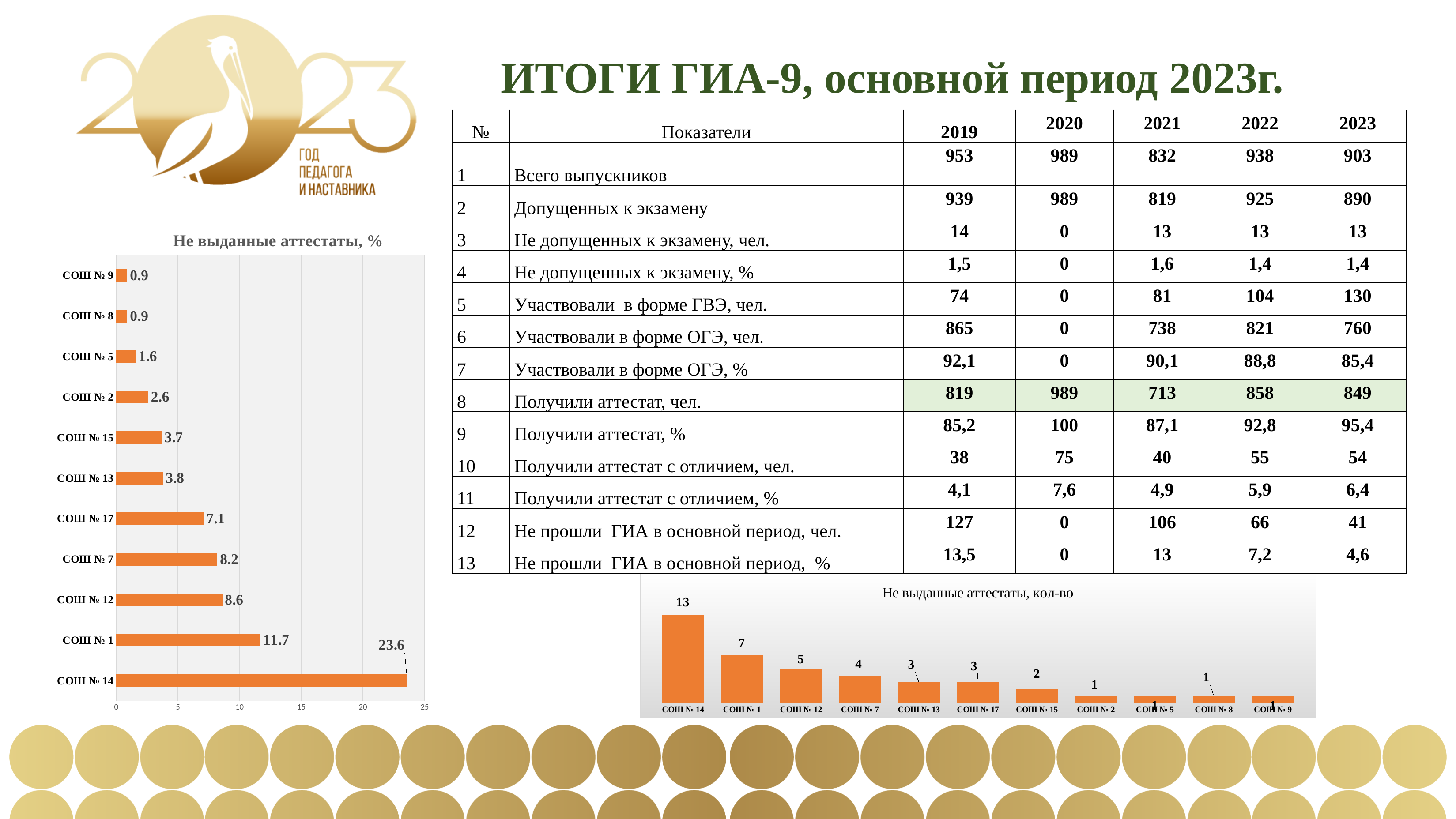
In the chart titled 'Не выданные аттестаты, %', what is the value for СОШ № 17? 7.1 In the chart titled 'Не выданные аттестаты, %', what is the value for СОШ № 14? 23.6 In the chart titled 'Не выданные аттестаты, кол-во', which is larger: the value for СОШ № 7 or the value for СОШ № 15? СОШ № 7 In the chart titled 'Не выданные аттестаты, кол-во', what is the value for СОШ № 12? 5 In the chart titled 'Не выданные аттестаты, %', which school has the highest value? СОШ № 14 In the chart titled 'Не выданные аттестаты, %', which is larger: the value for СОШ № 7 or the value for СОШ № 2? СОШ № 7 What kind of chart is the chart titled 'Не выданные аттестаты, %'? Bar chart In the chart titled 'Не выданные аттестаты, кол-во', do the values rise or fall from left to right along the x axis? Fall How many schools are shown in the chart titled 'Не выданные аттестаты, %'? 11 In the chart titled 'Не выданные аттестаты, кол-во', what is the difference between the values for СОШ № 14 and СОШ № 1? 6 In the chart titled 'Не выданные аттестаты, %', what is the difference between the values for СОШ № 1 and СОШ № 12? 3.1 In the chart titled 'Не выданные аттестаты, кол-во', what is the value for СОШ № 14? 13